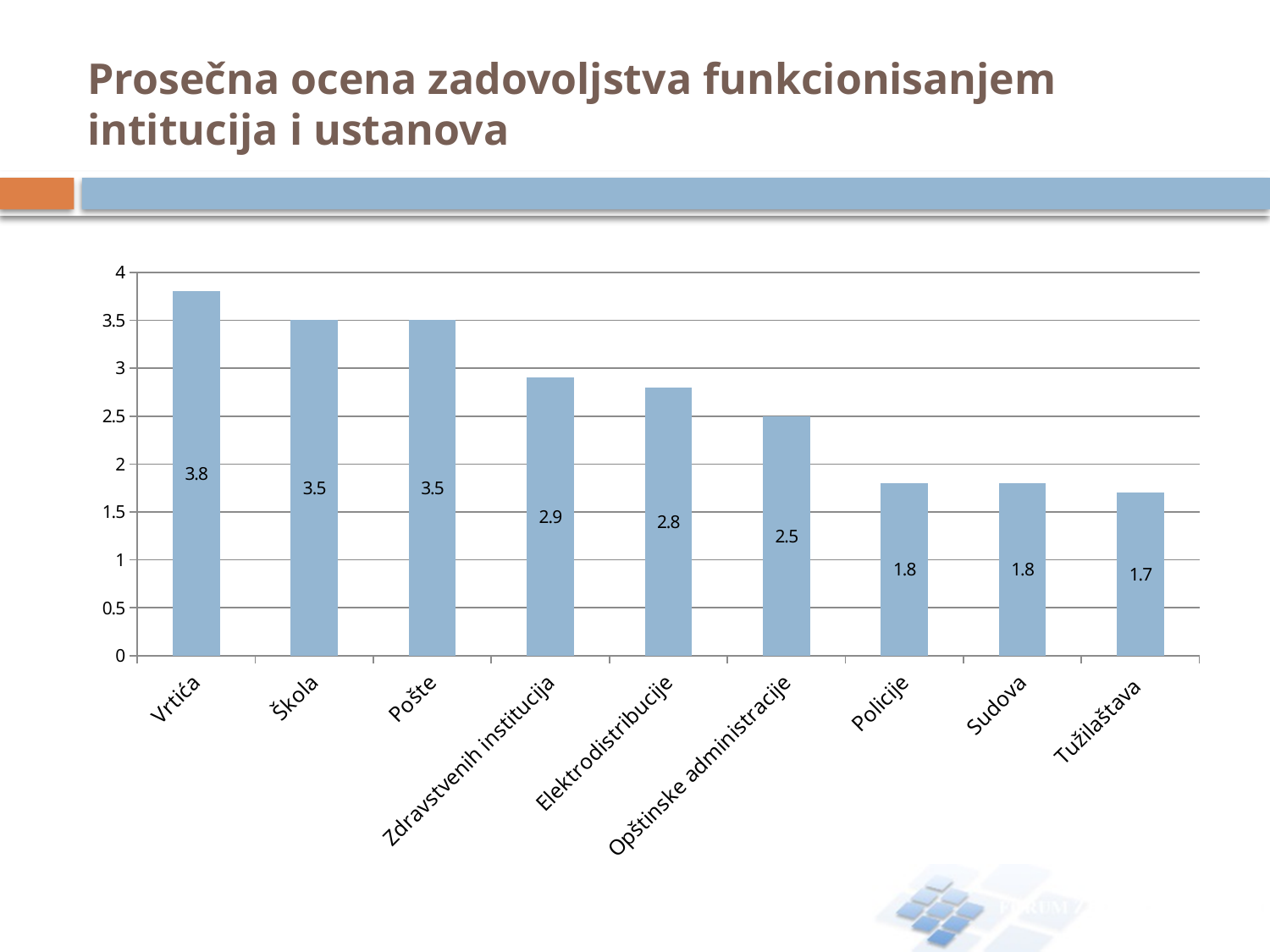
How many categories are shown on the x axis? 9 Which is larger, the value for Zdravstvenih institucija or the value for Opštinske administracije? Zdravstvenih institucija What is the value for Zdravstvenih institucija? 2.9 What is the value for Opštinske administracije? 2.5 What is the value for Tužilaštava? 1.7 Do the values rise or fall from left to right along the x axis? Fall Which category has the highest value? Vrtića What kind of chart is shown on the slide? Bar chart Which category has the lowest value? Tužilaštava What is the value for Vrtića? 3.8 What is the difference between the values for Vrtića and Tužilaštava? 2.1 What is the difference between the values for Škola and Elektrodistribucije? 0.7